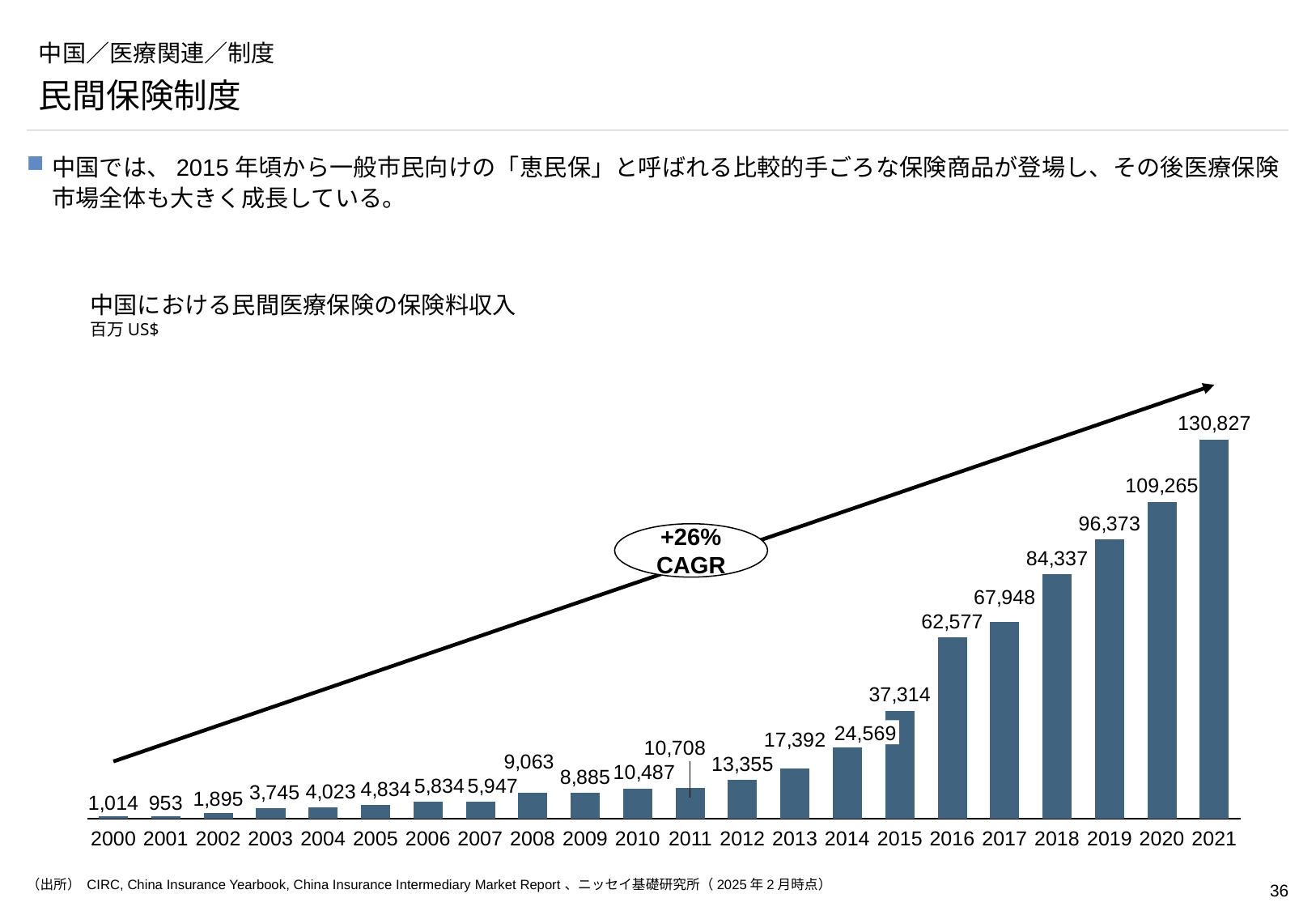
What is the difference between the 2016 and 2015 values? 25,263 What is the premium income value for 2008? 9,063 What is the difference between the 2021 and 2020 values? 21,562 What CAGR is annotated on the chart? +26% Do the values generally rise or fall from 2000 to 2021? Rise What type of chart is shown on the slide? Bar chart What is the premium income value for 2015? 37,314 Which year has the highest premium income? 2021 How many years are plotted on the x axis? 22 Which year has the lowest premium income? 2001 What is the premium income value for 2021? 130,827 Which is larger, the value for 2008 or the value for 2009? 2008